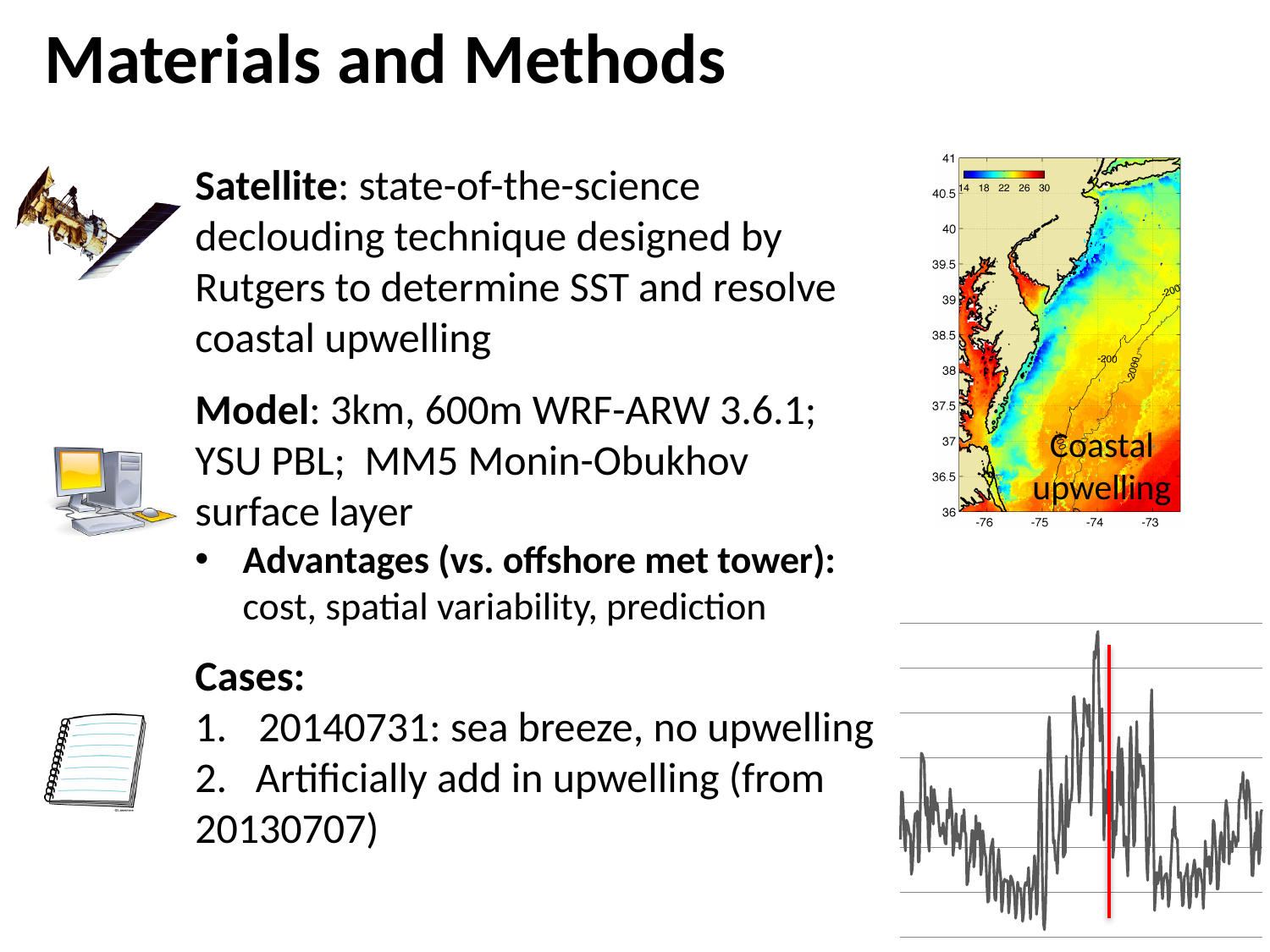
On the map at the top right, what are the lowest and highest values shown on the colour bar? 14 and 30 What kind of chart is shown at the bottom right of the slide? line chart In the bottom-right line chart, is the highest peak of the grey line to the left or to the right of the red vertical line? left In the bottom-right line chart, what colour is the vertical marker line? red